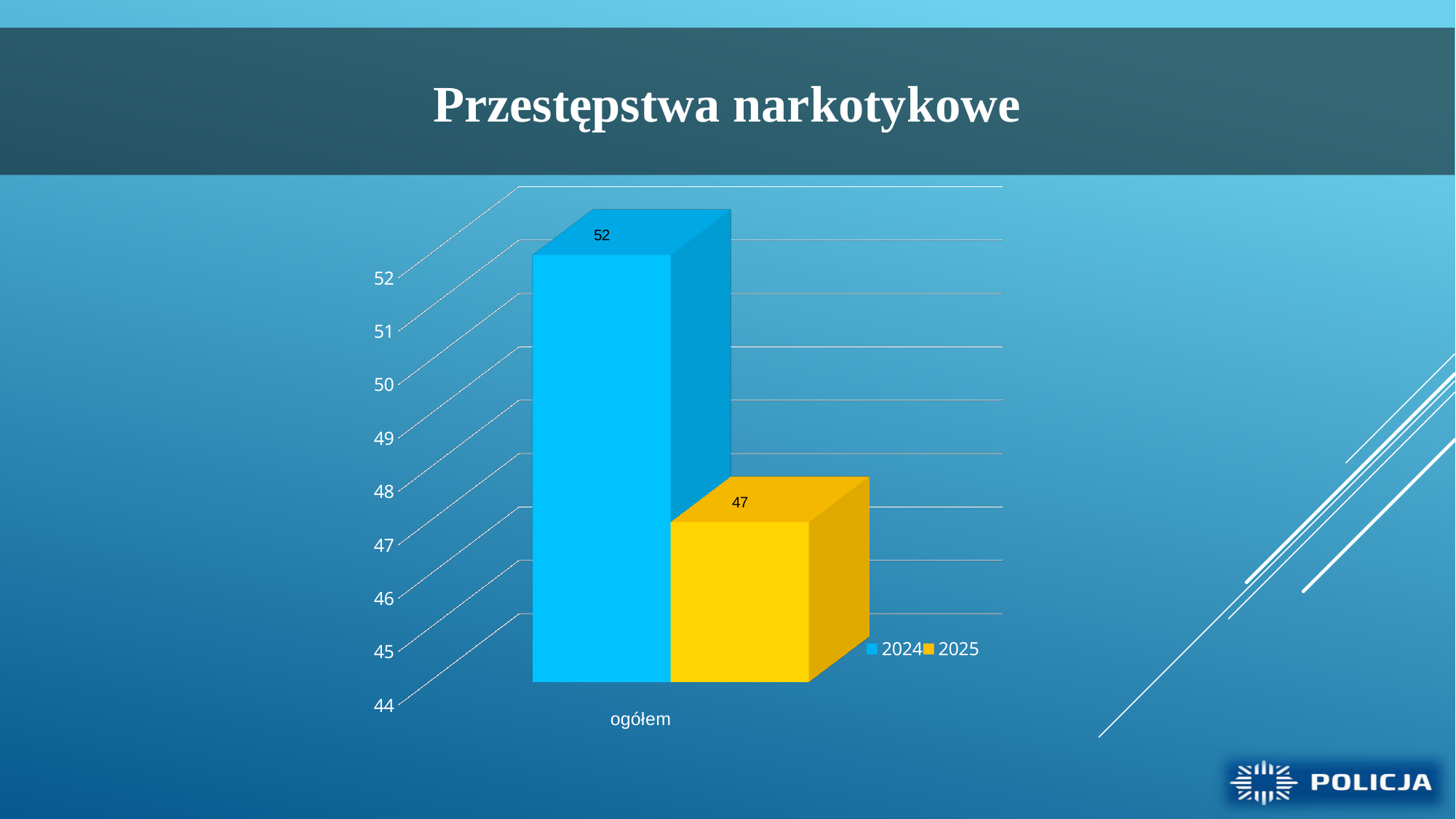
What kind of chart is shown on the slide? bar chart How many categories are shown on the x axis? 1 How many series does the legend list? 2 What colour is the bar for the 2025 series? yellow Is the value for 2025 greater or less than 50? less What is the difference between the 2024 and 2025 values for 'ogółem'? 5 Which series has the lowest value on the chart? 2025 Which series has the higher value for 'ogółem', 2024 or 2025? 2024 Is the value for 2024 greater or less than 50? greater What is the title of the slide containing the chart? Przestępstwa narkotykowe What is the value for 2024 in the 'ogółem' category? 52 What is the value for 2025 in the 'ogółem' category? 47